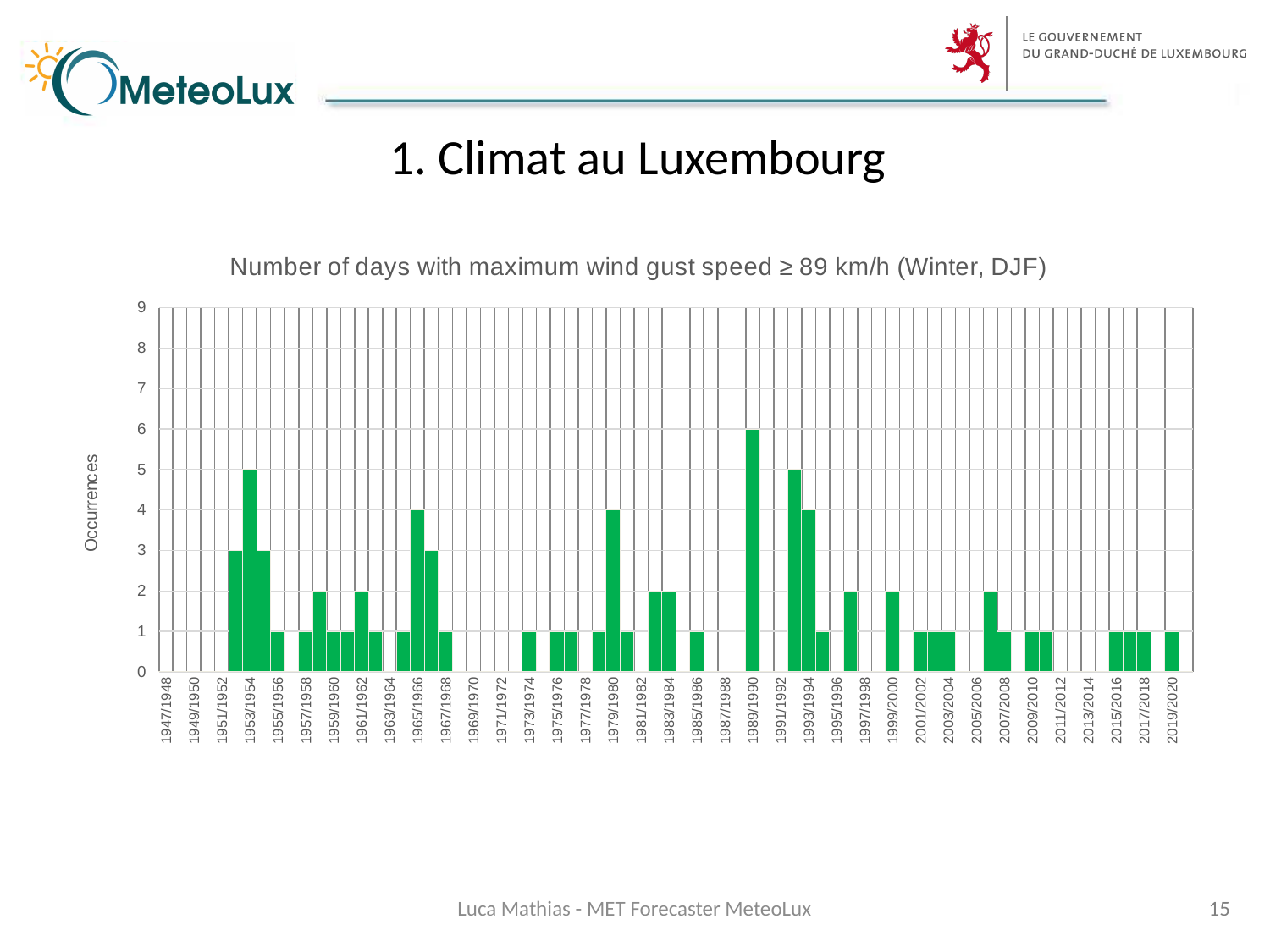
How many occurrences are shown for the winter 1965/1966? 4 What is the difference in occurrences between the winters 1989/1990 and 1979/1980? 2 How many occurrences are shown for the winter 1989/1990? 6 Which winter has more occurrences, 1989/1990 or 1953/1954? 1989/1990 Is the value for the winter 1989/1990 greater or less than 5? greater What is the title of the chart? Number of days with maximum wind gust speed ≥ 89 km/h (Winter, DJF) What is the label of the vertical axis? Occurrences Which winter has the highest number of occurrences? 1989/1990 What type of chart is shown on the slide? Bar chart How many occurrences are shown for the winter 2013/2014? 0 How many occurrences are shown for the winter 1953/1954? 5 How many occurrences are shown for the winter 1979/1980? 4